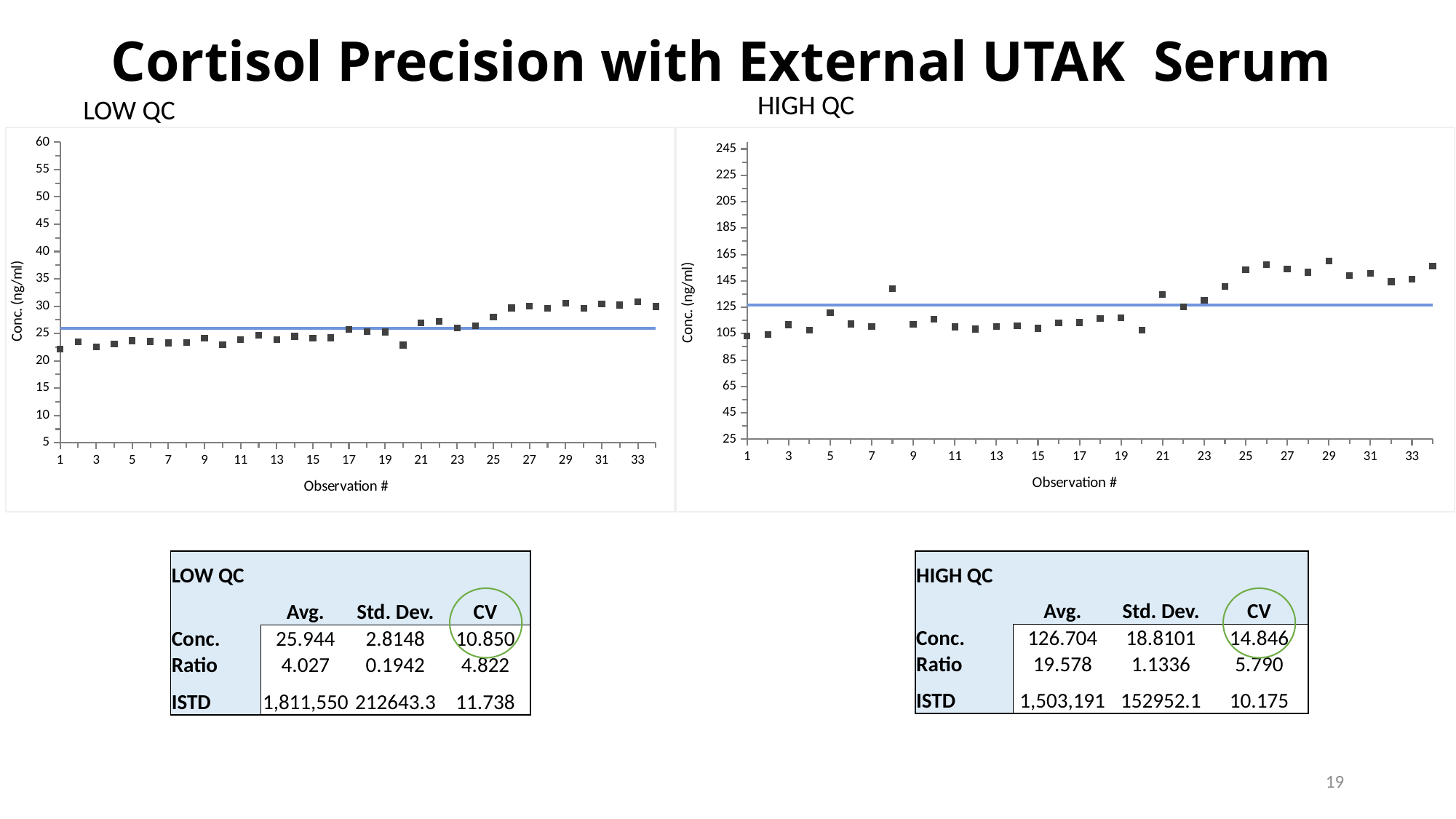
What kind of chart is the LOW QC chart? scatter chart In the HIGH QC chart, is the value for observation 29 greater or less than 145? greater In the HIGH QC chart, which is larger, the value for observation 1 or the value for observation 8? observation 8 In the LOW QC chart, which is larger, the value for observation 1 or the value for observation 33? observation 33 In the HIGH QC chart, is the value for observation 8 greater or less than 125? greater In the LOW QC chart, is the value for observation 33 greater or less than 30? greater In the LOW QC chart, do the values generally rise or fall from the first observations to the last observations? rise In the HIGH QC chart, do the values generally rise or fall from the first observations to the last observations? rise What is the y-axis title of the HIGH QC chart? Conc. (ng/ml) What is the x-axis title of the LOW QC chart? Observation #